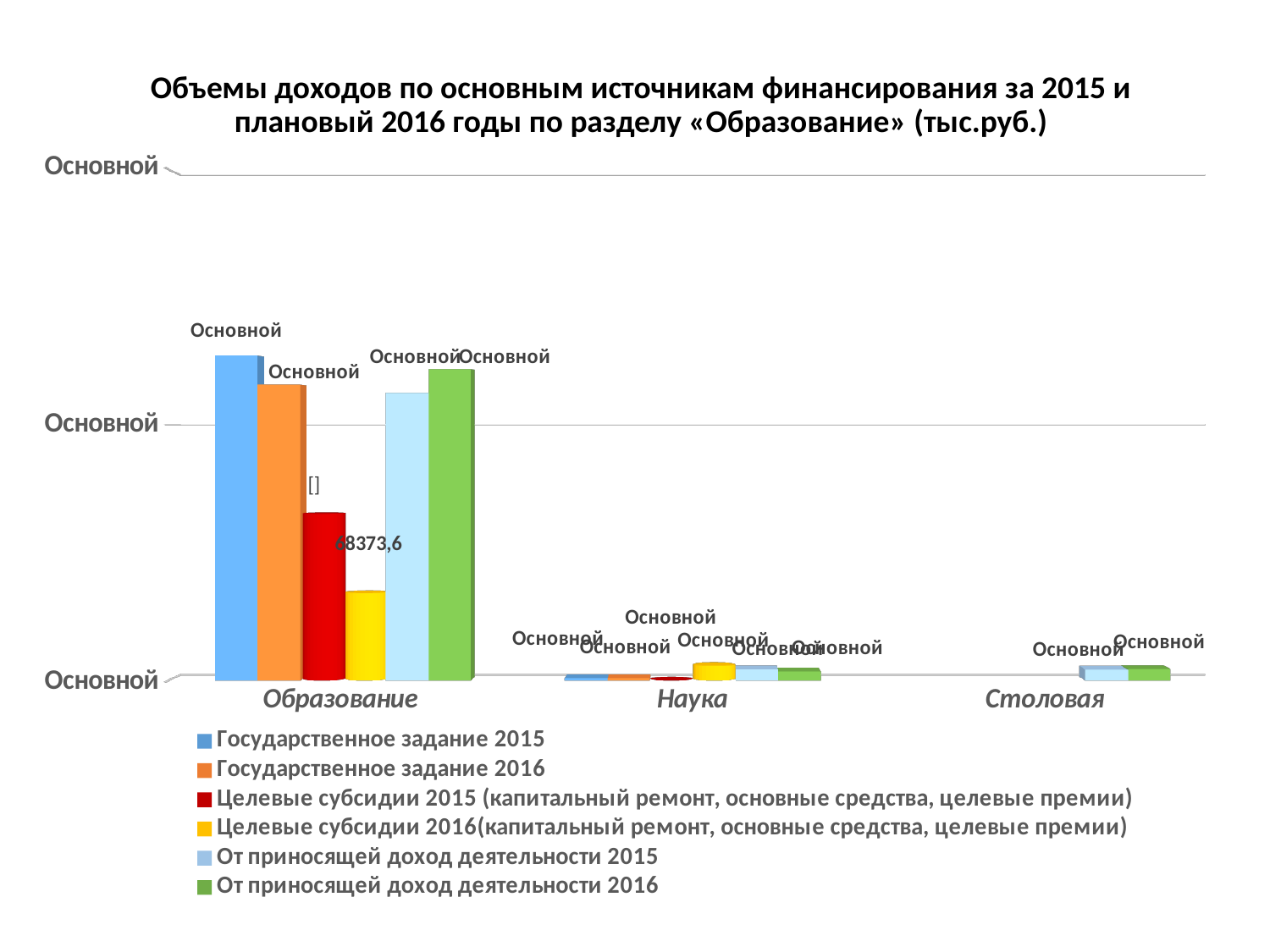
What is the title of the chart? Объемы доходов по основным источникам финансирования за 2015 и плановый 2016 годы по разделу «Образование» (тыс.руб.) In the Образование category, which is larger: Целевые субсидии 2015 or Целевые субсидии 2016? Целевые субсидии 2015 Within the Наука category, which series has the highest bar? Целевые субсидии 2016(капитальный ремонт, основные средства, целевые премии) How many series does the legend list? 6 Within the Образование category, which series has the lowest bar? Целевые субсидии 2016(капитальный ремонт, основные средства, целевые премии) How many categories are shown on the x axis? 3 What is the value printed for Целевые субсидии 2016 in the Образование category? 68373,6 Which colour represents Государственное задание 2016 in the legend? orange What kind of chart is shown on the slide? bar chart In the Образование category, which is larger: От приносящей доход деятельности 2015 or От приносящей доход деятельности 2016? От приносящей доход деятельности 2016 In the Образование category, which is larger: Государственное задание 2015 or Государственное задание 2016? Государственное задание 2015 Which category has the tallest bars overall? Образование